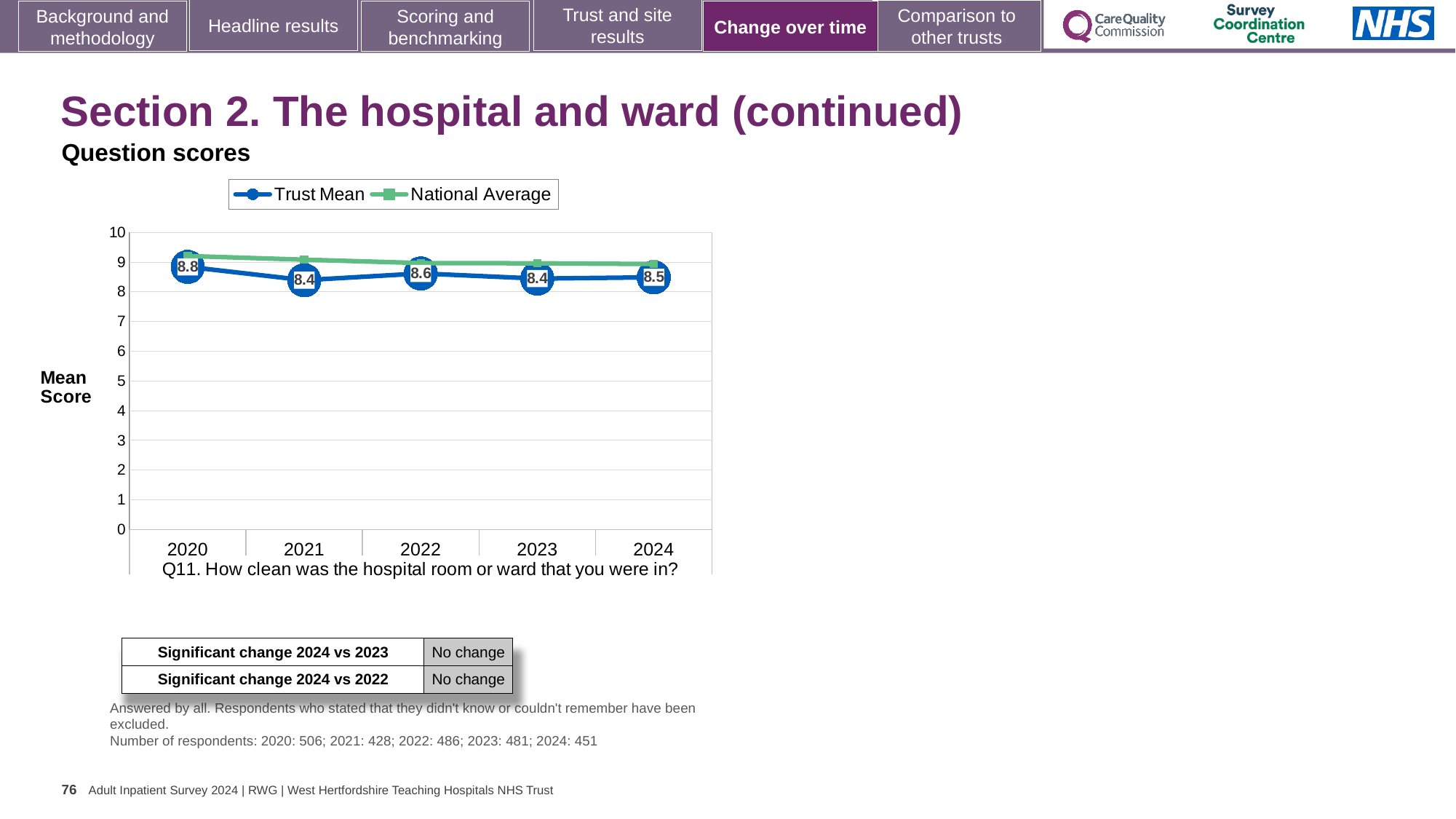
What is the Trust Mean value for 2022? 8.6 Is the National Average value for 2020 greater or less than 9? greater In which year is the Trust Mean highest? 2020 How many series does the legend list? 2 What is the Trust Mean value for 2020? 8.8 What is the Trust Mean value for 2024? 8.5 How many years are plotted on the x axis? 5 What is the difference between the Trust Mean in 2020 and in 2021? 0.4 Does the Trust Mean rise or fall from 2023 to 2024? Rise Which year has the larger Trust Mean, 2022 or 2023? 2022 Which survey question does the chart show scores for? Q11. How clean was the hospital room or ward that you were in? What kind of chart is shown on the slide? Line chart